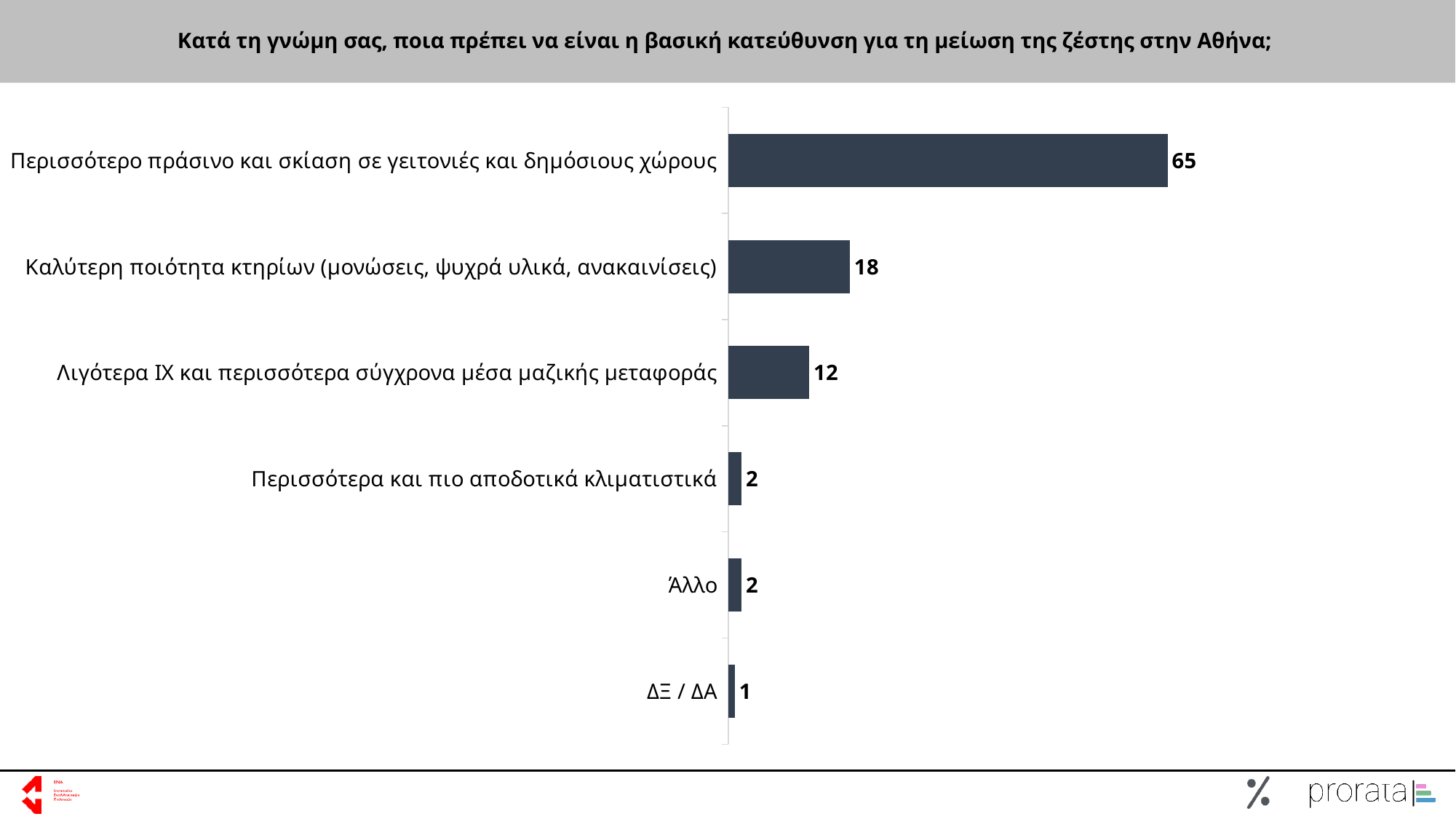
What is the title of the chart? Κατά τη γνώμη σας, ποια πρέπει να είναι η βασική κατεύθυνση για τη μείωση της ζέστης στην Αθήνα; How many categories are shown in the chart? 6 What is the value for 'Περισσότερο πράσινο και σκίαση σε γειτονιές και δημόσιους χώρους'? 65 What is the value for 'ΔΞ / ΔΑ'? 1 What is the value for 'Καλύτερη ποιότητα κτηρίων (μονώσεις, ψυχρά υλικά, ανακαινίσεις)'? 18 What is the value for 'Περισσότερα και πιο αποδοτικά κλιματιστικά'? 2 Which is larger: the value for 'Καλύτερη ποιότητα κτηρίων (μονώσεις, ψυχρά υλικά, ανακαινίσεις)' or for 'Λιγότερα ΙΧ και περισσότερα σύγχρονα μέσα μαζικής μεταφοράς'? Καλύτερη ποιότητα κτηρίων (μονώσεις, ψυχρά υλικά, ανακαινίσεις) What kind of chart is shown on the slide? Bar chart Which category has the lowest value? ΔΞ / ΔΑ What is the value for 'Λιγότερα ΙΧ και περισσότερα σύγχρονα μέσα μαζικής μεταφοράς'? 12 Which category has the highest value? Περισσότερο πράσινο και σκίαση σε γειτονιές και δημόσιους χώρους What is the difference between the values for 'Περισσότερο πράσινο και σκίαση σε γειτονιές και δημόσιους χώρους' and 'Καλύτερη ποιότητα κτηρίων (μονώσεις, ψυχρά υλικά, ανακαινίσεις)'? 47